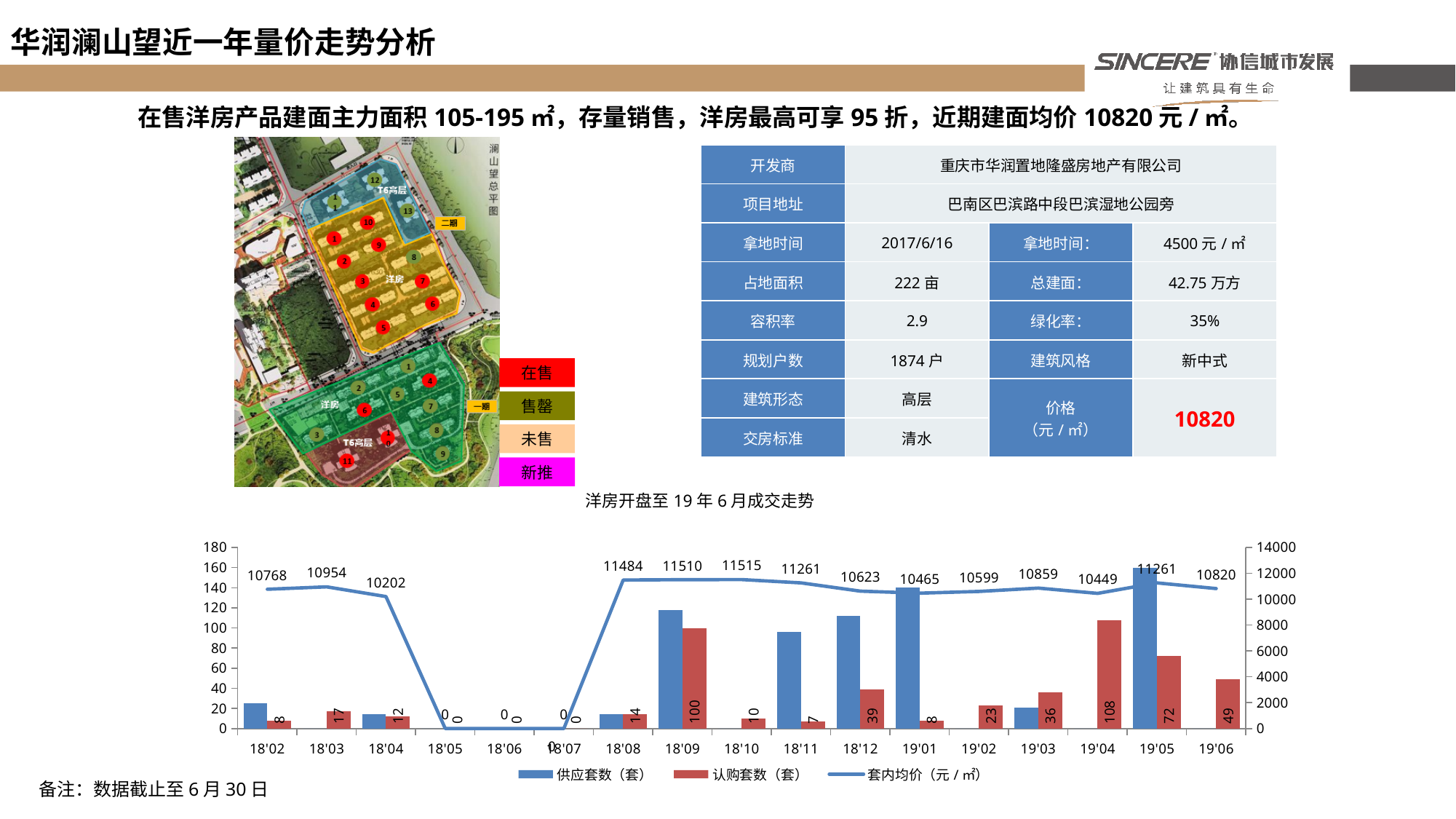
Which month has the highest 认购套数? 19'04 How many months are shown on the x axis of the chart? 17 Which month has the highest 套内均价 among the non-zero values? 18'10 What is the 认购套数 value for 19'04? 108 What is the 套内均价 value for 19'06? 10820 What kind of chart is shown under the title 洋房开盘至19年6月成交走势? combined bar and line chart How many series does the legend of the chart list? 3 Which is larger, the 认购套数 for 18'09 or for 18'12? 18'09 What is the 套内均价 value for 18'02? 10768 Does the 套内均价 line rise or fall from 19'05 to 19'06? fall What is the difference between the 认购套数 for 19'04 and 19'05? 36 Is the 供应套数 value for 19'05 greater or less than 140? greater